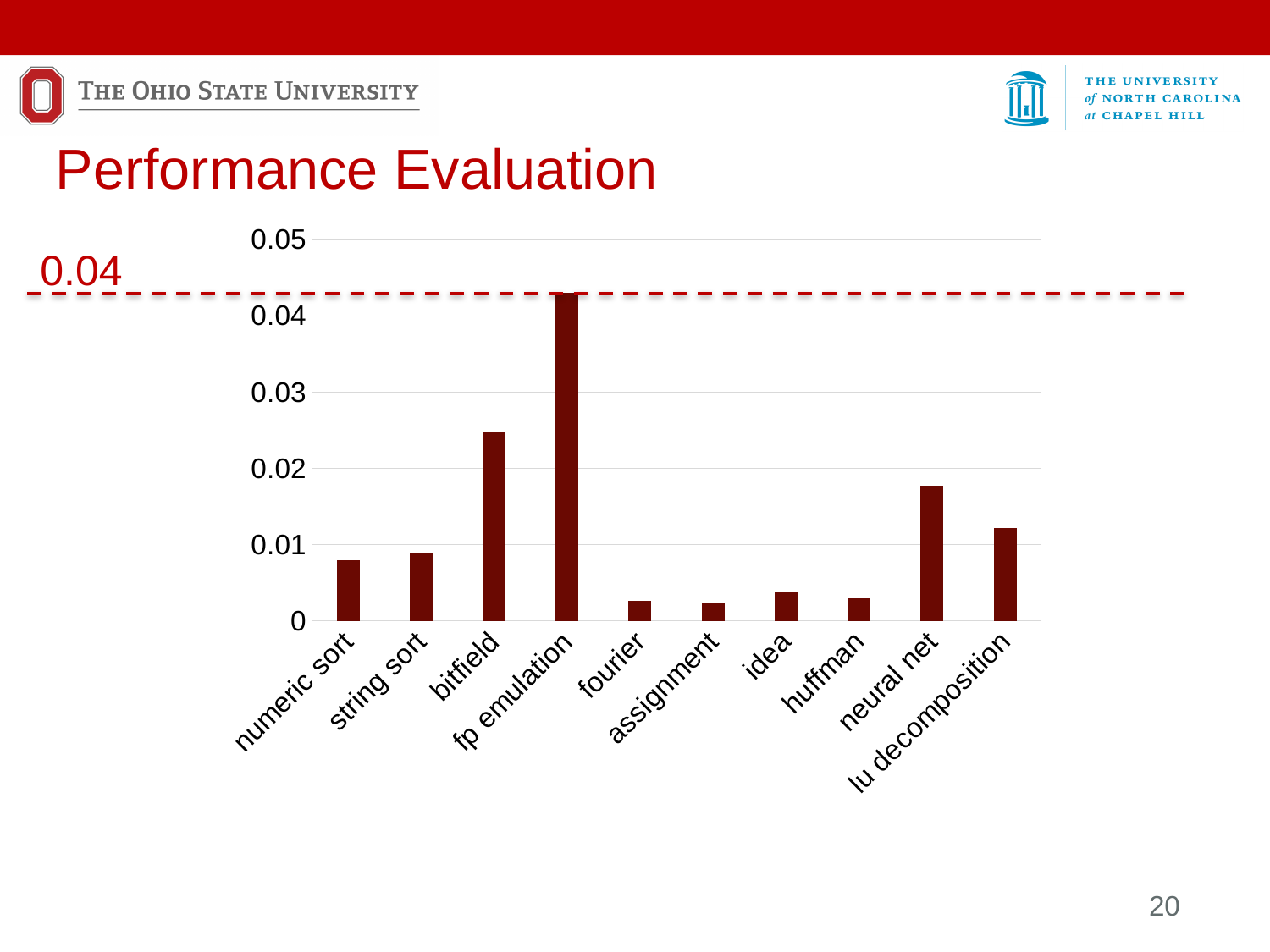
Which category has the highest bar in the chart? fp emulation Is the value for fp emulation greater or less than 0.04? greater Is the value for neural net greater or less than 0.02? less What value is marked by the red dashed horizontal line across the chart? 0.04 How many categories are plotted on the x axis of the chart? 10 What kind of chart is shown on the slide? bar chart Is the value for fourier greater or less than 0.01? less Which is larger, the value for bitfield or the value for neural net? bitfield What is the title of the slide containing the chart? Performance Evaluation Which is larger, the value for neural net or the value for lu decomposition? neural net